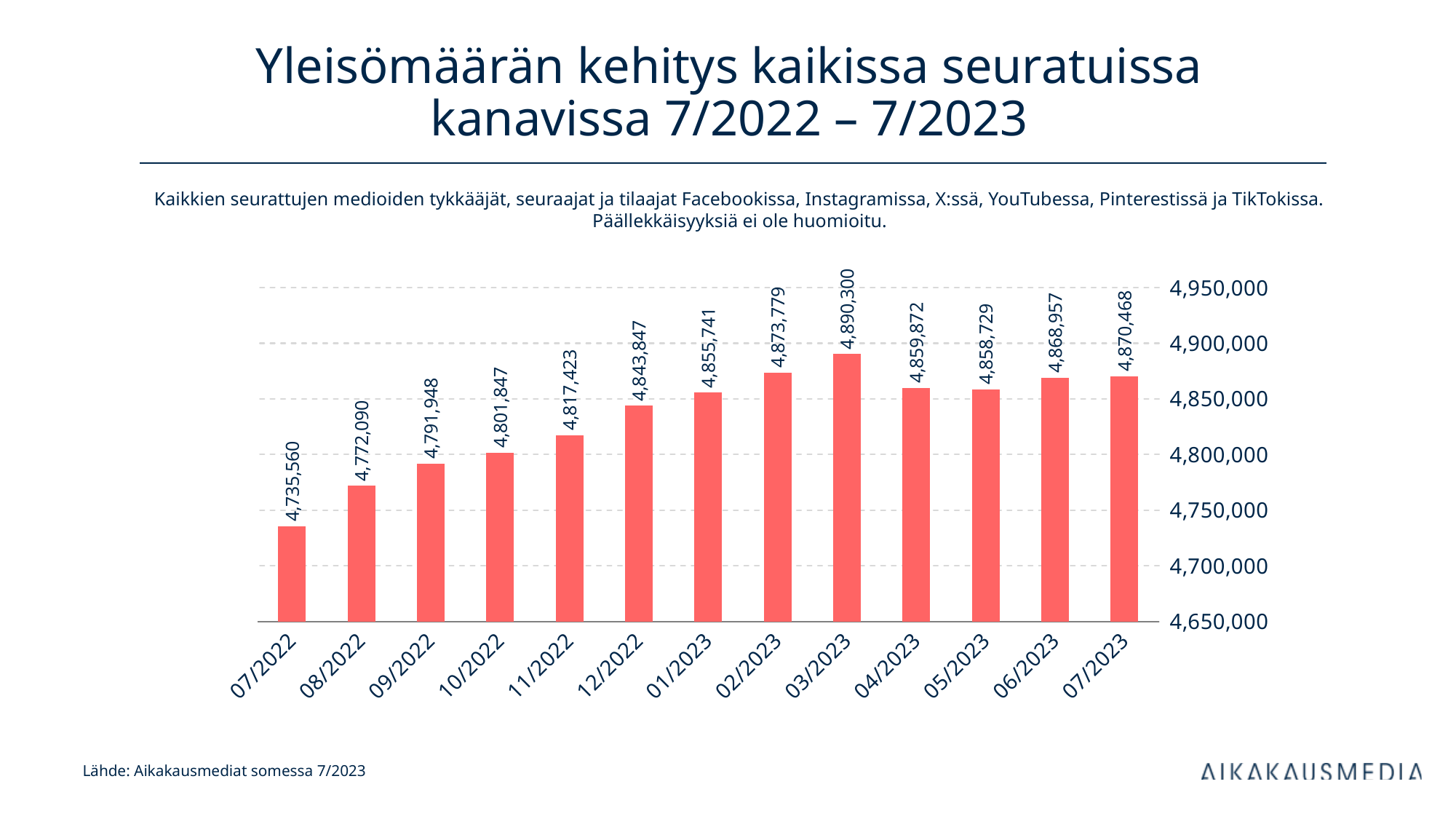
What is the value for 07/2022? 4,735,560 Do the values generally rise or fall from 07/2022 to 03/2023? rise How many months are shown on the x axis? 13 Which month has the highest value? 03/2023 What is the value for 07/2023? 4,870,468 What kind of chart is shown on the slide? bar chart What is the difference between the values for 07/2023 and 07/2022? 134,908 Which month has the lowest value? 07/2022 Which is larger, the value for 02/2023 or the value for 04/2023? 02/2023 What is the value for 03/2023? 4,890,300 What is the value for 12/2022? 4,843,847 Is the value for 10/2022 greater or less than 4,800,000? greater